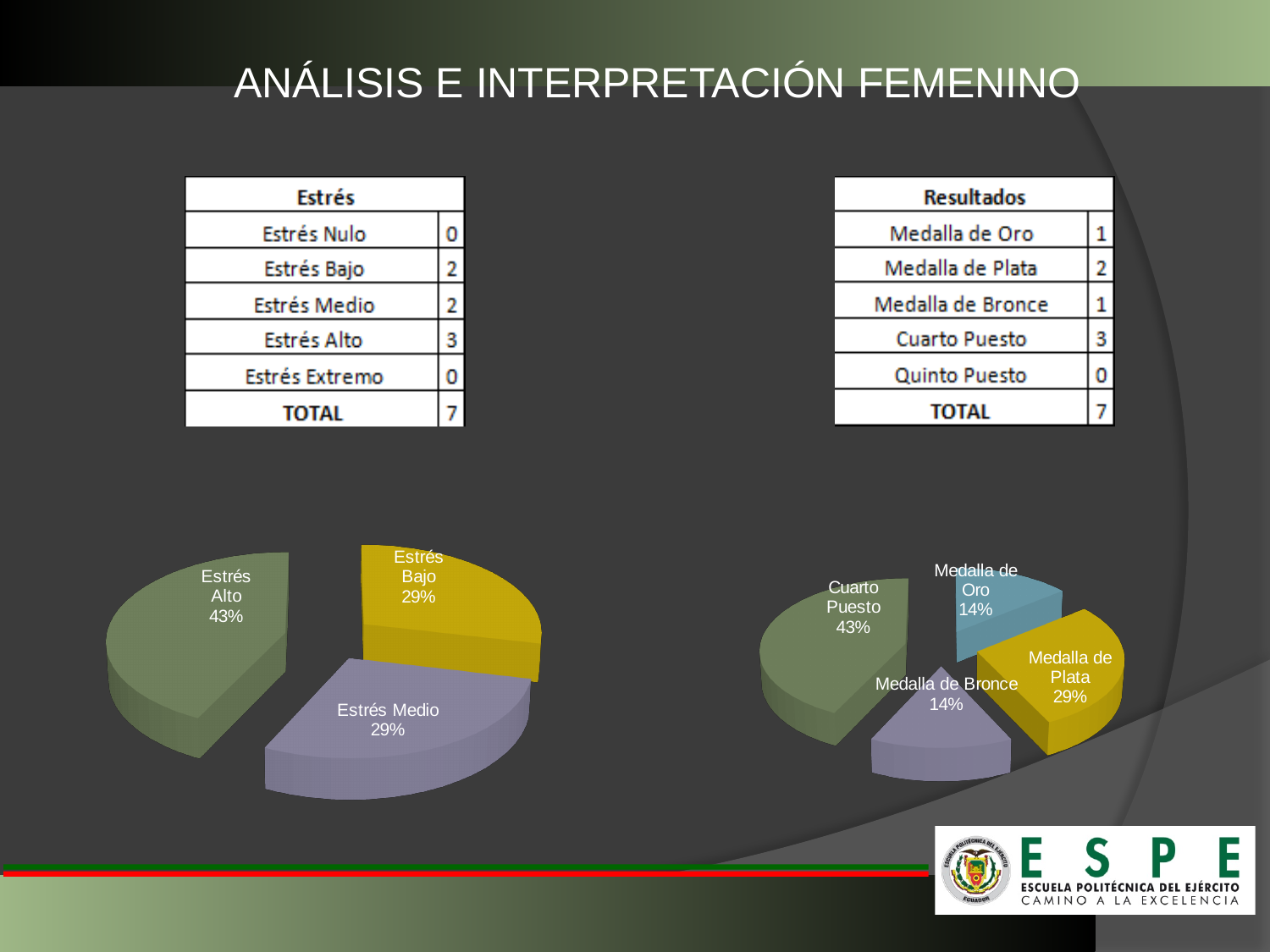
In the right pie chart, what share does Medalla de Oro have? 14% In the right pie chart, which is larger: Medalla de Plata or Medalla de Bronce? Medalla de Plata In the right pie chart, which slice is the largest? Cuarto Puesto What kind of chart is the chart on the left of the slide? pie chart How many slices does the right pie chart have? 4 In the left pie chart, what share does Estrés Alto have? 43% In the left pie chart, what share does Estrés Medio have? 29% In the right pie chart, what is the difference between the shares of Cuarto Puesto and Medalla de Bronce? 29% In the right pie chart, what share does Medalla de Plata have? 29% In the left pie chart, what is the difference between the shares of Estrés Alto and Estrés Bajo? 14% How many slices does the left pie chart have? 3 In the left pie chart, which slice is the largest? Estrés Alto